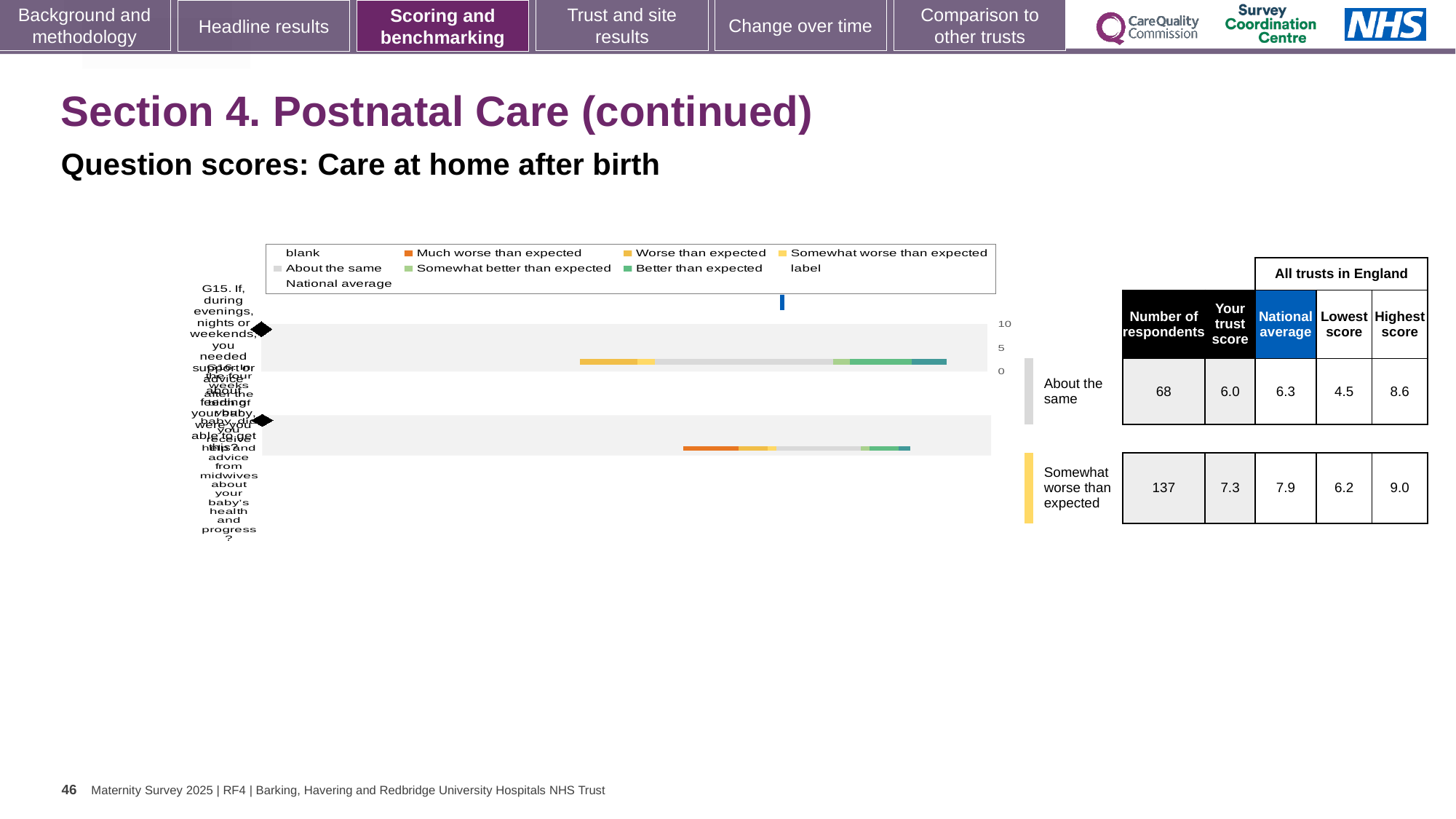
What colour does the legend use for 'Much worse than expected'? orange What kind of chart is shown on the slide? bar chart What is the trust score for the row rated 'Somewhat worse than expected'? 7.3 What is the lowest score among all trusts in England for the row rated 'About the same'? 4.5 For the row rated 'Somewhat worse than expected', what is the difference between the national average and the trust score? 0.6 What is the number of respondents for the row rated 'Somewhat worse than expected'? 137 Which row has more respondents, 'About the same' or 'Somewhat worse than expected'? Somewhat worse than expected What is the number of respondents for the row rated 'About the same'? 68 What is the highest score among all trusts in England for the row rated 'Somewhat worse than expected'? 9.0 How many question rows (bars) are plotted in the chart? 2 What is the national average for the row rated 'About the same'? 6.3 What is the highest tick value shown on the chart's axis? 10